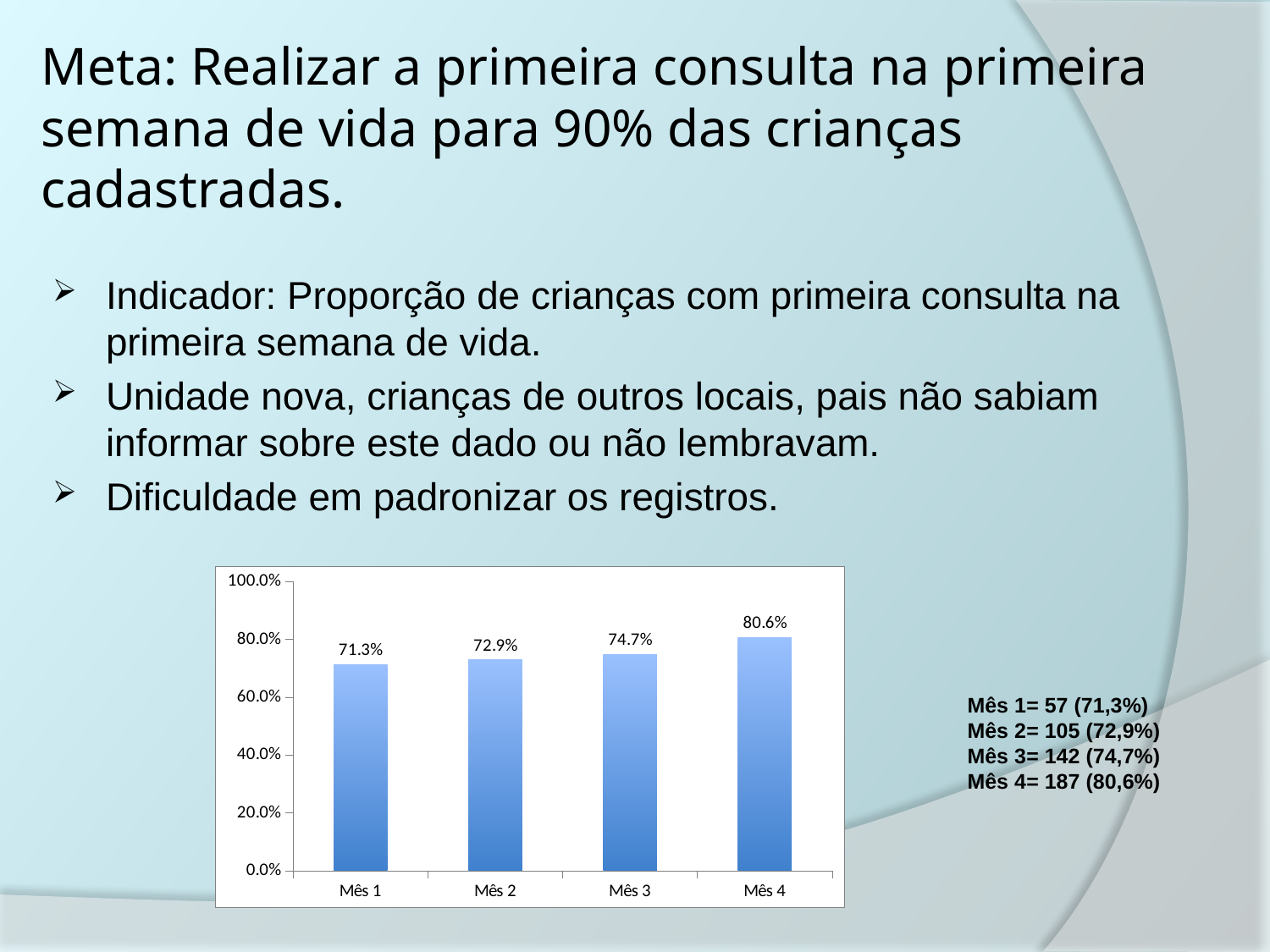
What is the difference between the values for Mês 4 and Mês 1? 9.3% How many months are shown on the x axis? 4 Which month has the lowest value? Mês 1 Which is larger, the value for Mês 2 or the value for Mês 4? Mês 4 Which month has the highest value? Mês 4 What is the value for Mês 1? 71.3% What is the value for Mês 3? 74.7% Is the value for Mês 4 greater or less than 80.0%? greater What is the value for Mês 4? 80.6% Do the values rise or fall from Mês 1 to Mês 4? rise What is the difference between the values for Mês 3 and Mês 2? 1.8% What kind of chart is shown on the slide? bar chart